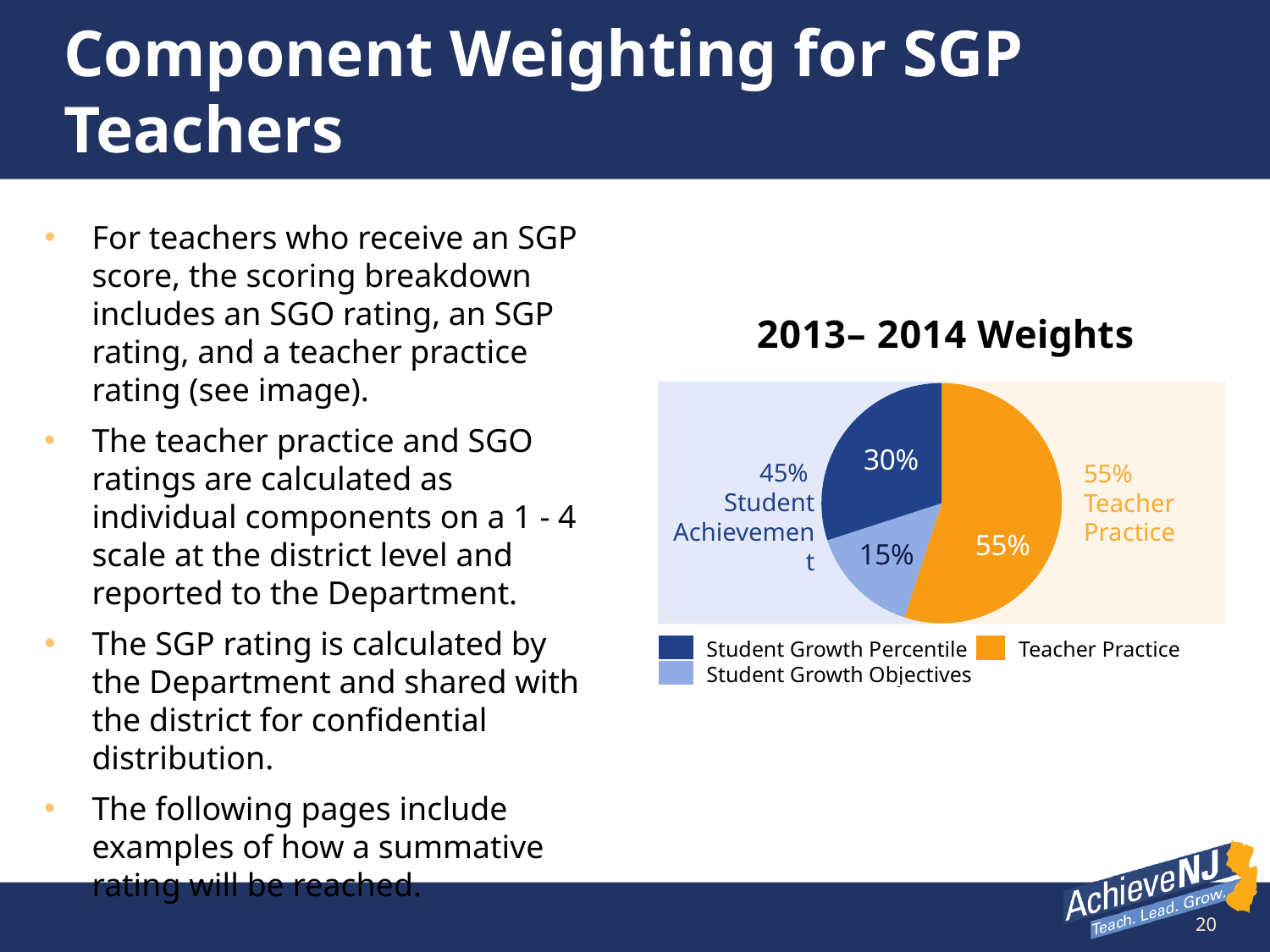
How many slices does the pie chart have? 3 What is the title of the pie chart? 2013– 2014 Weights What is the value for Student Growth Objectives in the pie chart? 15% What is the value for Student Growth Percentile in the pie chart? 30% Which slice of the pie chart is the largest? Teacher Practice What is the difference between the Teacher Practice and Student Growth Percentile values? 25% What is the value for Teacher Practice in the pie chart? 55% Which is larger, Student Growth Percentile or Student Growth Objectives? Student Growth Percentile What is the difference between the Student Growth Percentile and Student Growth Objectives values? 15% What is the combined share of Student Growth Percentile and Student Growth Objectives, as labelled on the chart? 45% Which slice of the pie chart is the smallest? Student Growth Objectives What type of chart is shown under the title "2013– 2014 Weights"? pie chart